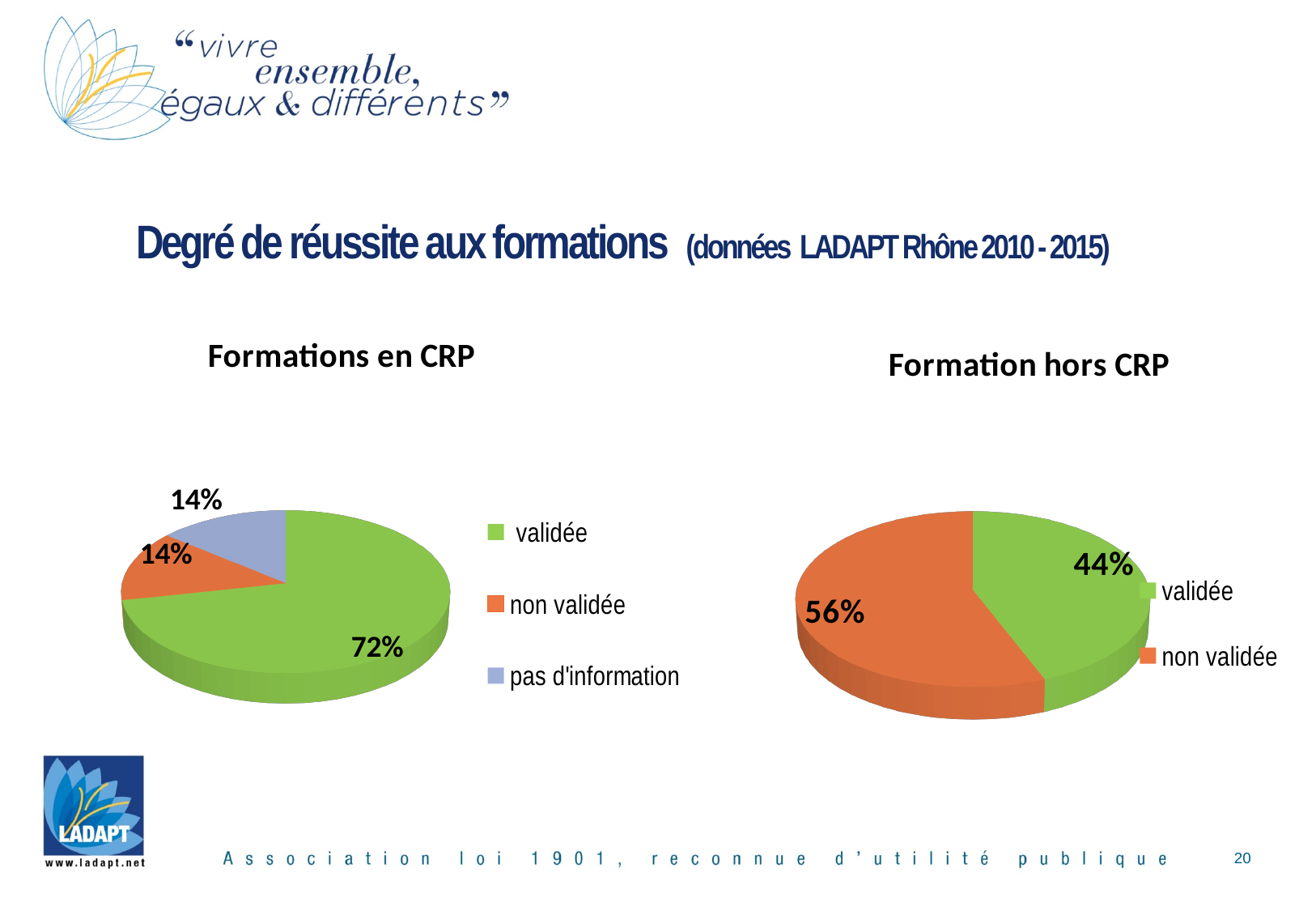
How many entries does the legend of the 'Formation hors CRP' chart list? 2 In the 'Formation hors CRP' chart, what share of the pie is 'validée'? 44% How many categories does the 'Formations en CRP' chart show? 3 In the 'Formation hors CRP' chart, what share of the pie is 'non validée'? 56% In the 'Formation hors CRP' chart, what is the difference between 'non validée' and 'validée'? 12% In the 'Formations en CRP' chart, what share of the pie is 'non validée'? 14% In the 'Formations en CRP' chart, which category has the largest slice? validée In the 'Formation hors CRP' chart, which category has the smallest slice? validée In the 'Formation hors CRP' chart, which is larger, 'validée' or 'non validée'? non validée What kind of chart is the 'Formations en CRP' chart? pie chart